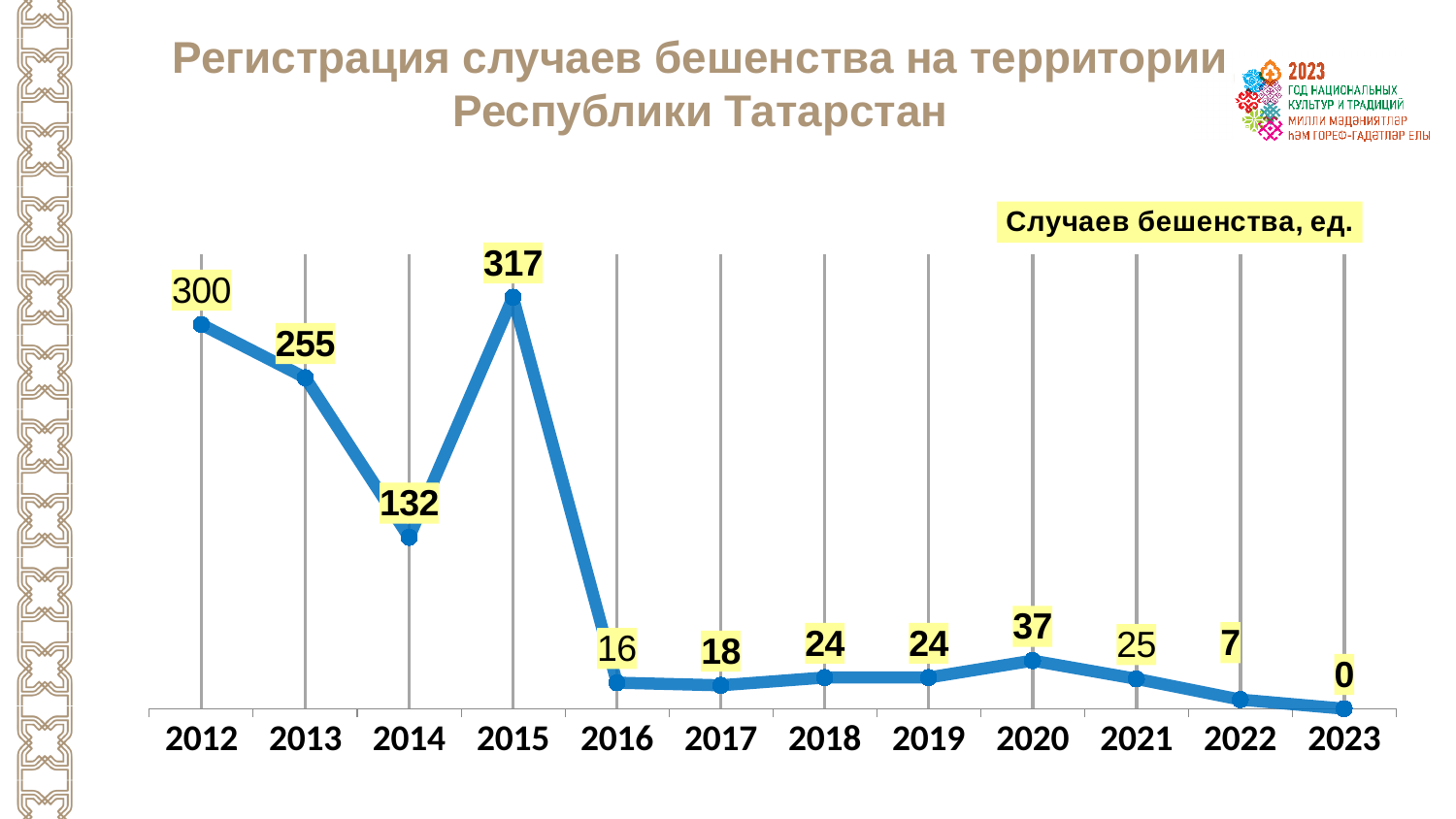
Which year has the lowest number of rabies cases? 2023 How many rabies cases were registered in 2015? 317 What is the legend label of the plotted series? Случаев бешенства, ед. Do the values rise or fall from 2020 to 2023? fall What is the value for 2020? 37 What is the difference between the values for 2015 and 2016? 301 Which is larger, the value for 2020 or the value for 2021? 2020 How many years are plotted on the chart? 12 What is the value for 2014? 132 What is the difference between the values for 2012 and 2013? 45 Which year has the highest number of rabies cases? 2015 What type of chart is shown on the slide? line chart